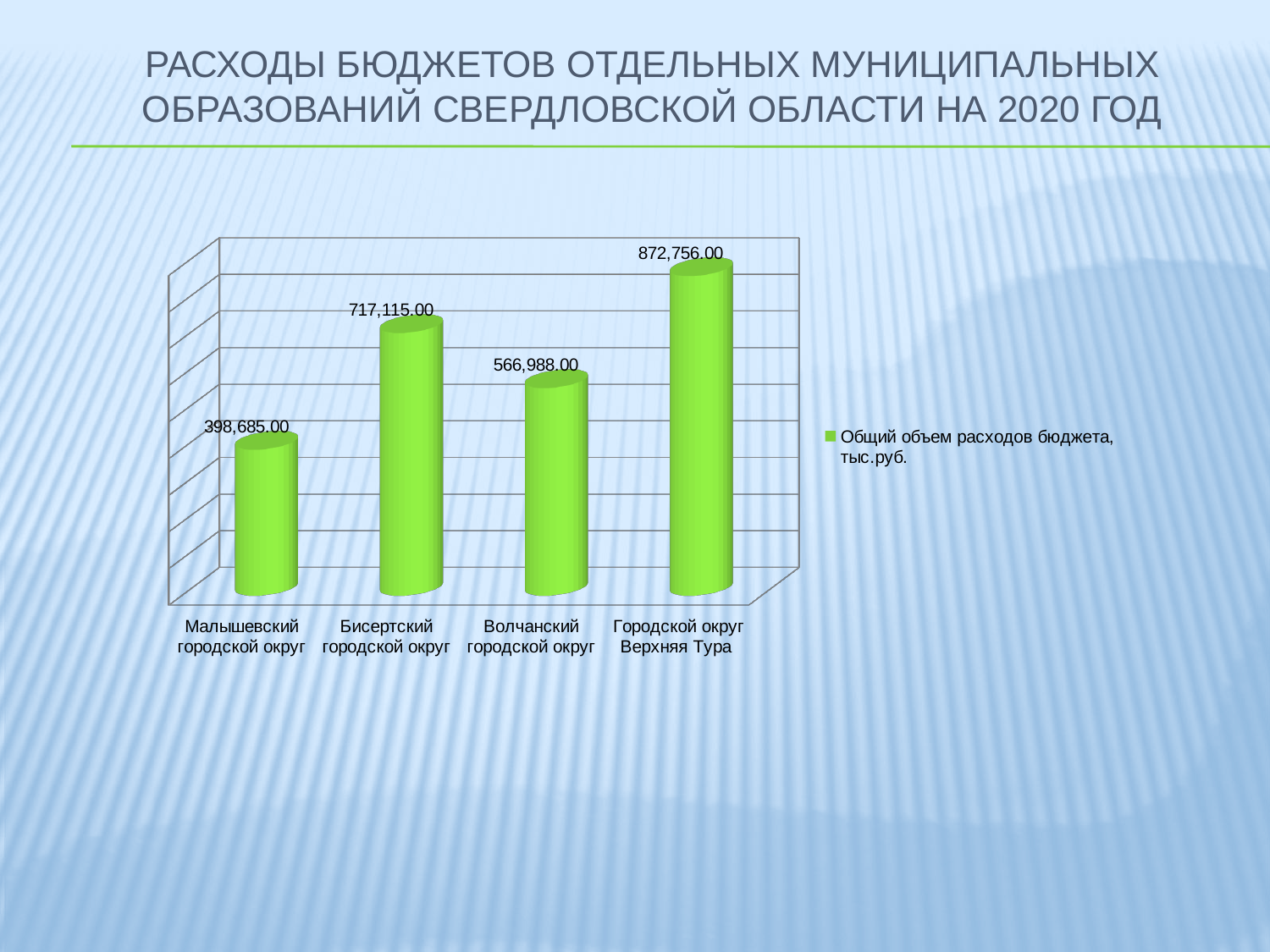
What is the value for Малышевский городской округ? 398,685.00 What is the value for Городской округ Верхняя Тура? 872,756.00 Which municipality has the highest budget expenditure? Городской округ Верхняя Тура What is the difference between the values for Бисертский городской округ and Волчанский городской округ? 150,127.00 What is the value for Бисертский городской округ? 717,115.00 What is the value for Волчанский городской округ? 566,988.00 How many series does the legend list? 1 What is the difference between the values for Городской округ Верхняя Тура and Малышевский городской округ? 474,071.00 How many municipalities are shown on the chart? 4 Which is larger, the value for Бисертский городской округ or Волчанский городской округ? Бисертский городской округ Which municipality has the lowest budget expenditure? Малышевский городской округ What kind of chart is shown on the slide? Bar chart